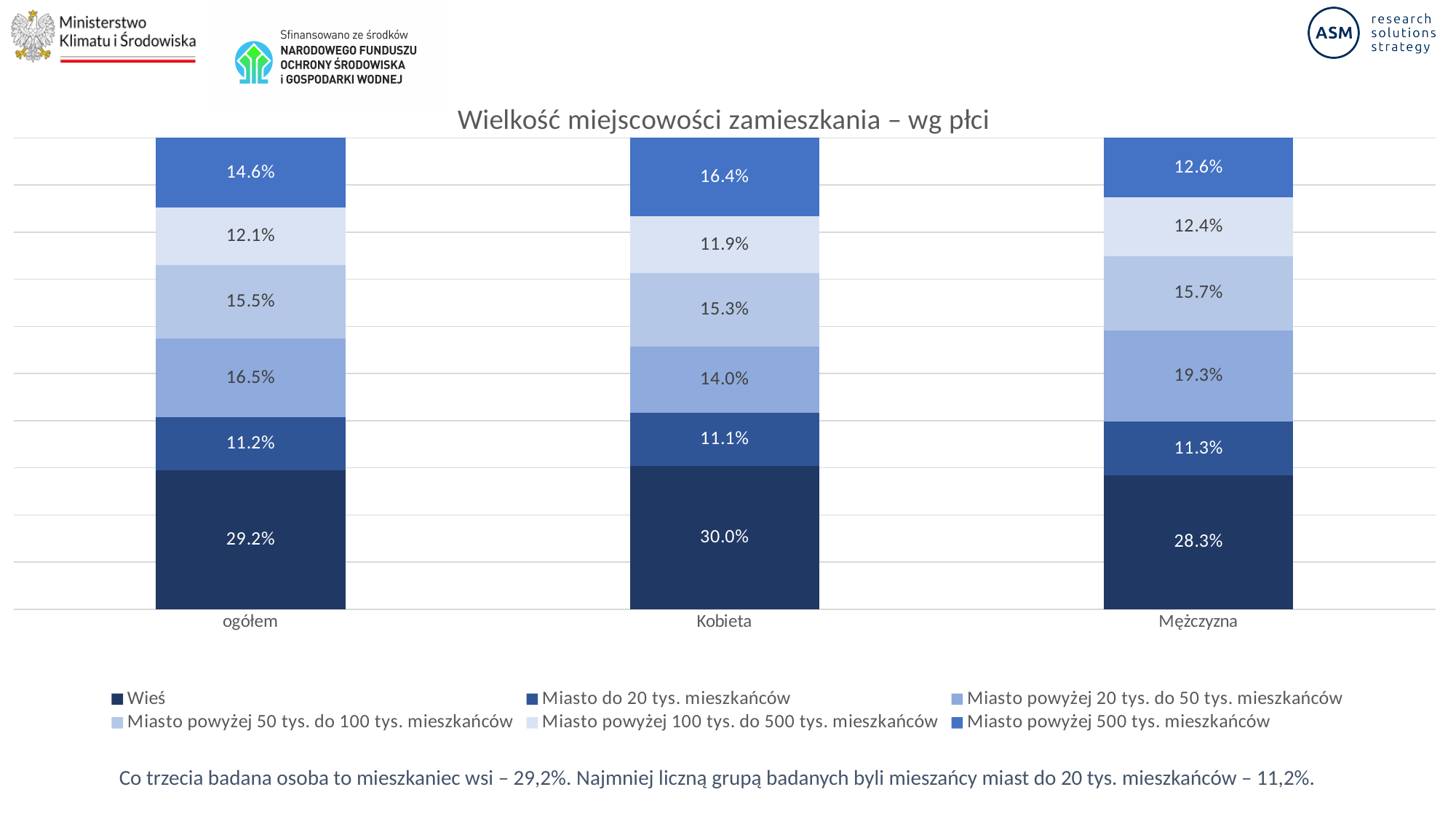
How many categories are shown on the x axis? 3 What kind of chart is shown on the slide? Stacked bar chart What is the title of the chart? Wielkość miejscowości zamieszkania – wg płci What is the value for Miasto powyżej 20 tys. do 50 tys. mieszkańców in the Mężczyzna bar? 19.3% Which category (ogółem, Kobieta, Mężczyzna) has the highest share of Wieś residents? Kobieta What is the difference between the Wieś share for Kobieta and for Mężczyzna? 1.7 percentage points What is the share of Wieś (village) residents among Kobieta (women)? 30.0% Which is larger: the Miasto powyżej 500 tys. mieszkańców share for Kobieta or for Mężczyzna? Kobieta What is the value for Miasto powyżej 100 tys. do 500 tys. mieszkańców in the ogółem bar? 12.1% Which segment is the smallest in the ogółem bar? Miasto do 20 tys. mieszkańców How many series does the legend list? 6 What is the value for Miasto powyżej 500 tys. mieszkańców in the Mężczyzna bar? 12.6%